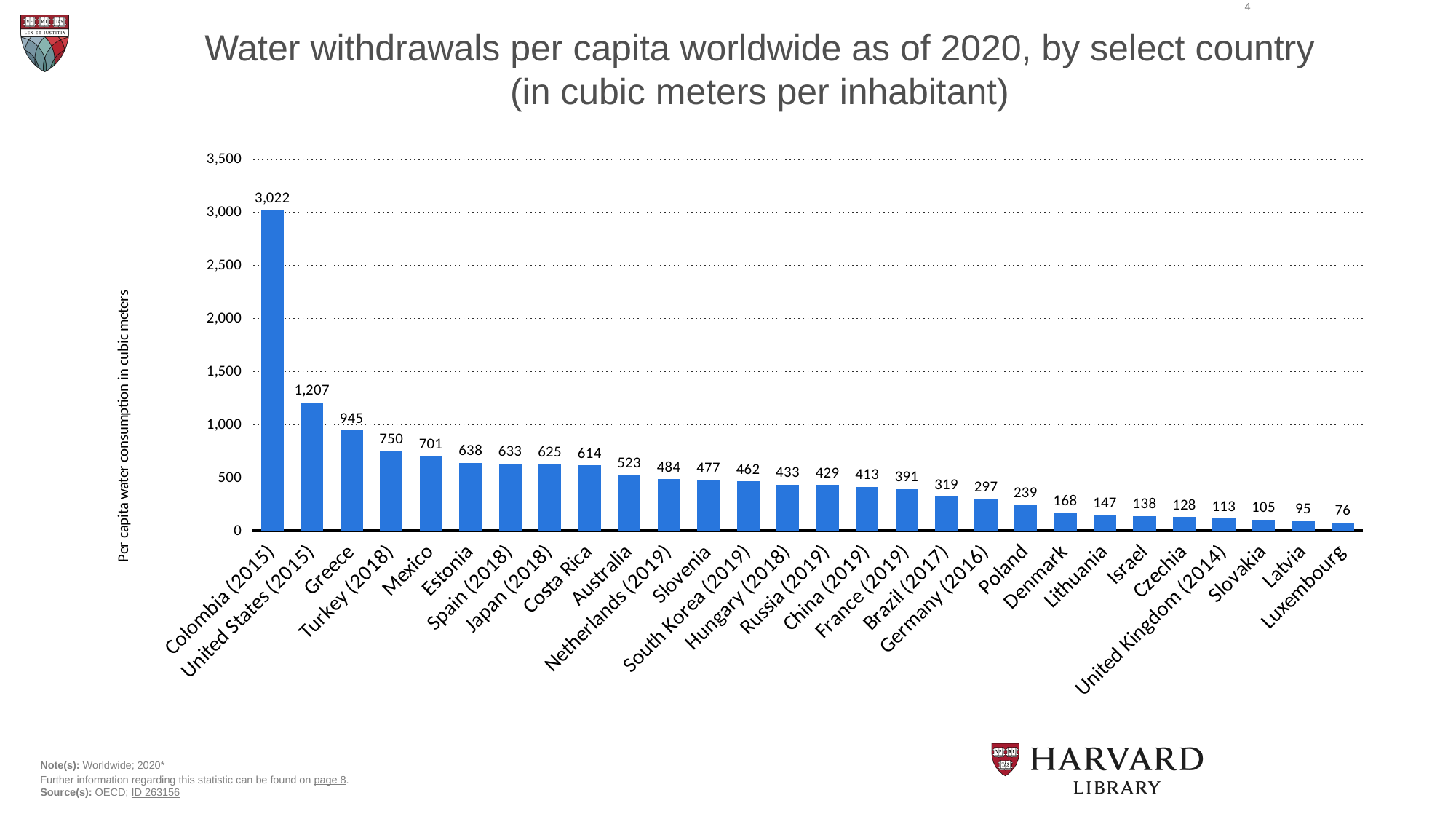
Which has a larger value, Australia or Slovenia? Australia Which country has the highest water withdrawals per capita? Colombia (2015) Which country has the lowest water withdrawals per capita? Luxembourg What is the difference between the values for the United States (2015) and Greece? 262 What is the label of the vertical axis? Per capita water consumption in cubic meters What is the value for Colombia (2015)? 3,022 What is the difference between the values for Turkey (2018) and Mexico? 49 What is the value for Poland? 239 What is the value for Japan (2018)? 625 Is the value for Brazil (2017) greater or less than 500? less How many countries are shown in the chart? 28 What kind of chart is shown on the slide? Bar chart